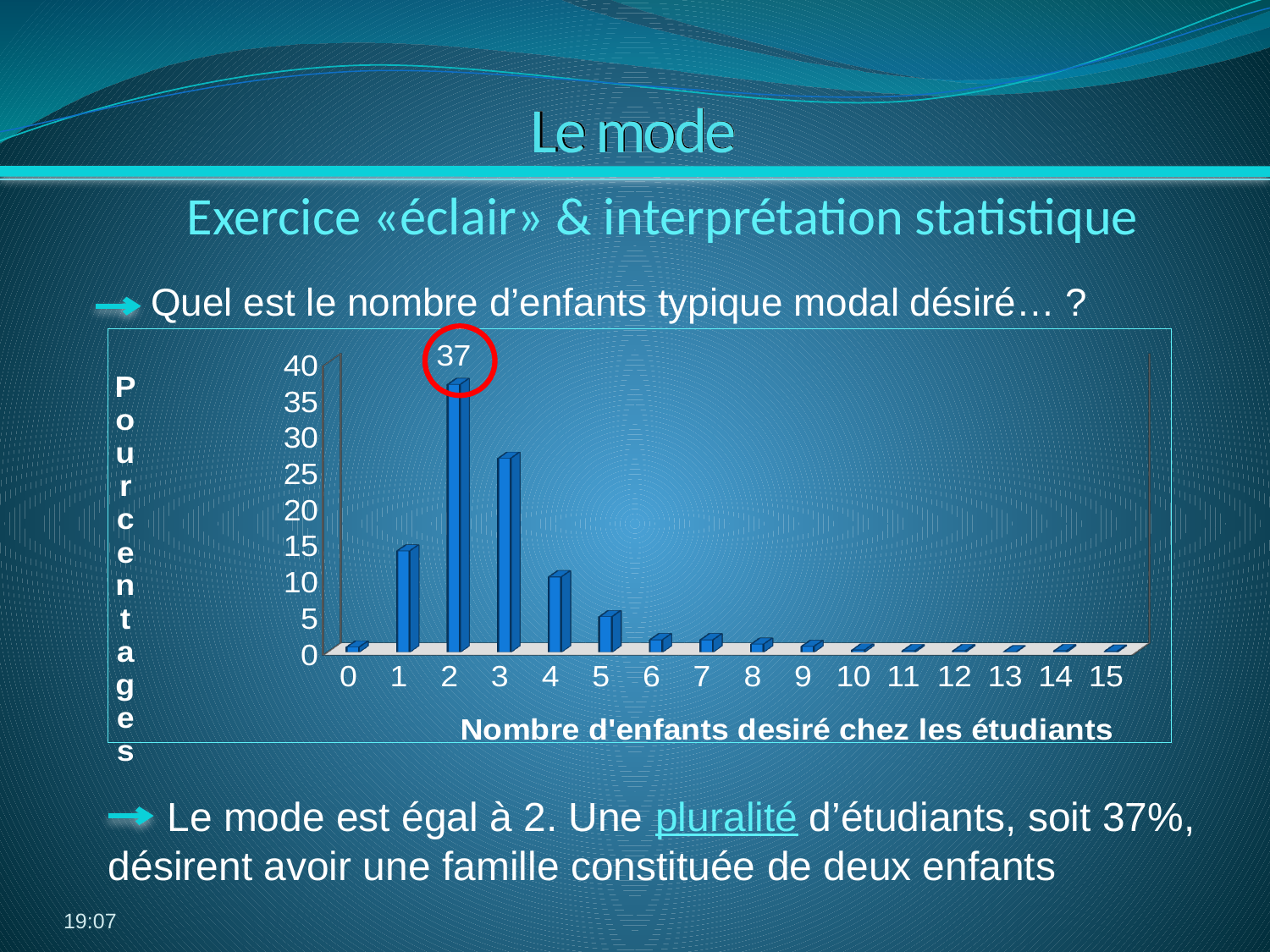
Is the value for 1 child greater or less than 20? less What is the title of the x axis? Nombre d'enfants desiré chez les étudiants Is the value for 3 children greater or less than 20? greater From 2 children onward to 15, do the values rise or fall along the x axis? fall Which number of children has the highest percentage? 2 Is the value for 5 children greater or less than 10? less Which has the larger percentage, 4 children or 5 children? 4 children How many categories are shown on the x axis? 16 Which has the larger percentage, 1 child or 3 children? 3 children What kind of chart is shown on the slide? bar chart What is the percentage value shown for 2 children desired? 37